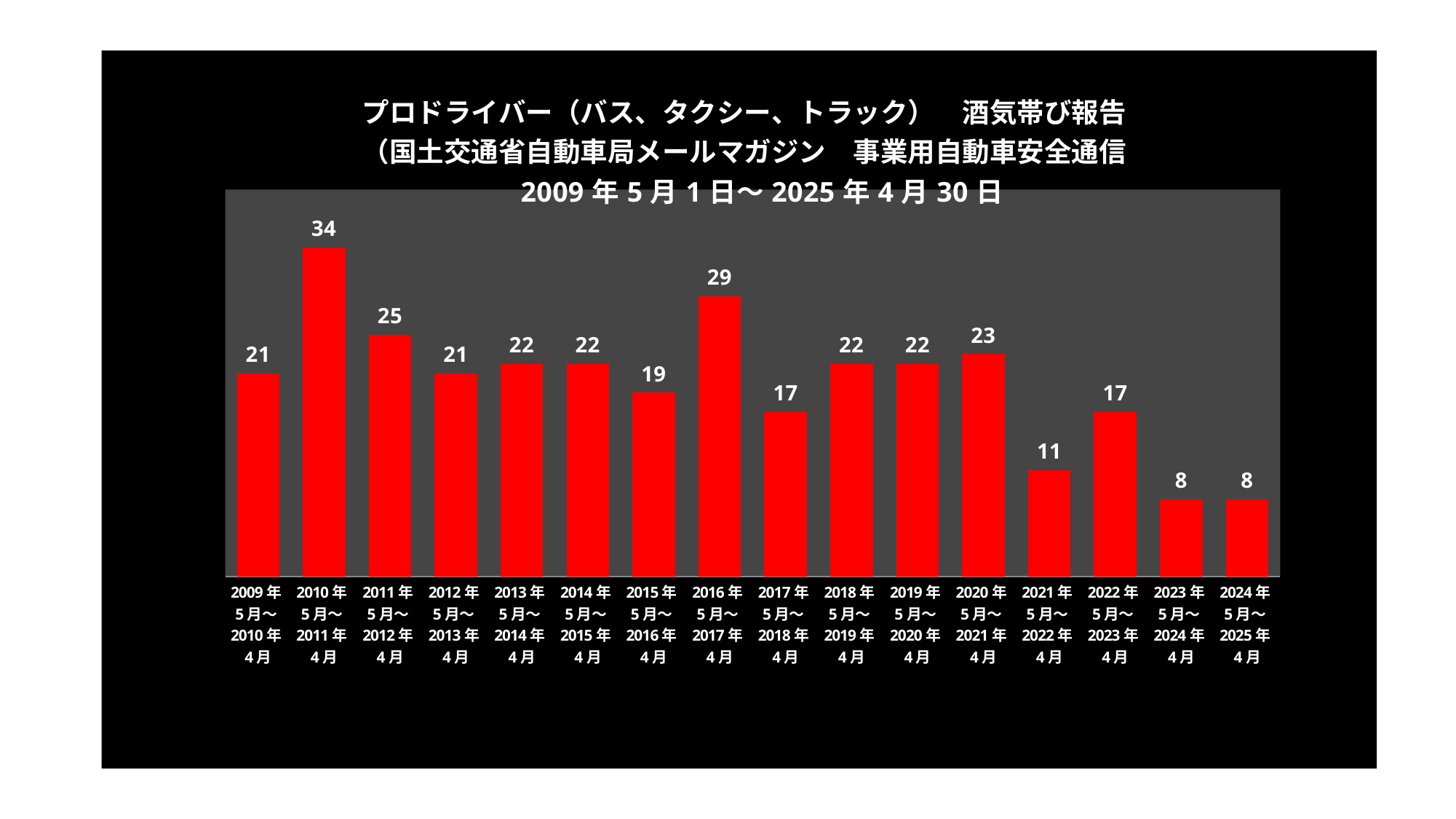
What type of chart is shown on the slide? bar chart What is the value for the period 2010年5月〜2011年4月? 34 What is the difference between the values for 2010年5月〜2011年4月 and 2011年5月〜2012年4月? 9 Which period has the highest value? 2010年5月〜2011年4月 What is the value for the period 2016年5月〜2017年4月? 29 Do the values generally rise or fall from 2020年5月〜2021年4月 to 2024年5月〜2025年4月? fall What is the value for the period 2021年5月〜2022年4月? 11 Which is larger, the value for 2016年5月〜2017年4月 or the value for 2017年5月〜2018年4月? 2016年5月〜2017年4月 How many bars (periods) are plotted in the chart? 16 What is the value for the period 2024年5月〜2025年4月? 8 What colour are the bars in the chart? red What is the lowest value shown in the chart? 8